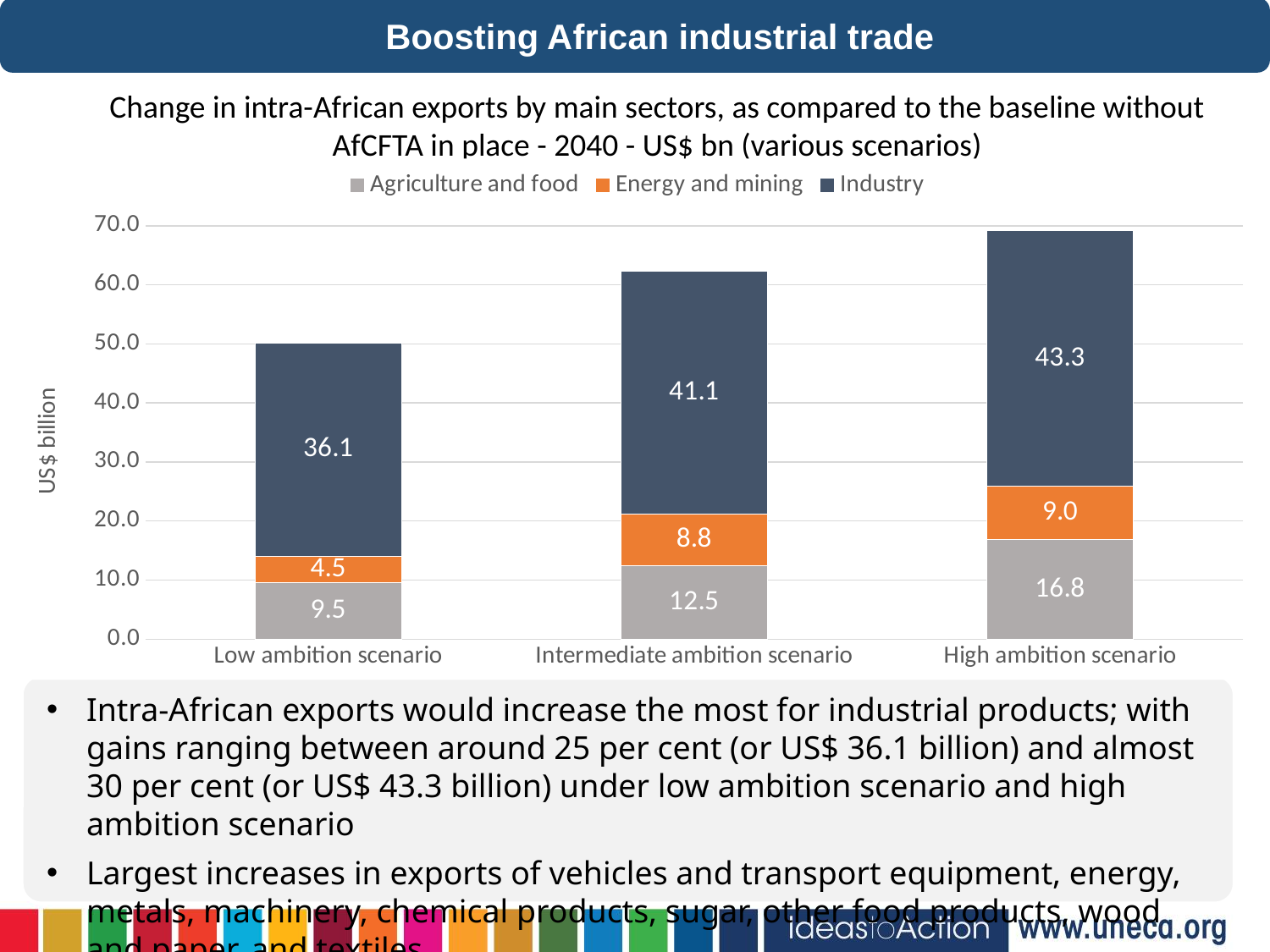
What is the total of the stacked bar for the High ambition scenario? 69.1 Which scenario has the lowest Agriculture and food value? Low ambition scenario What is the Energy and mining value for the Intermediate ambition scenario? 8.8 How many series does the legend list? 3 What is the Agriculture and food value for the High ambition scenario? 16.8 Which scenario has the highest Industry value? High ambition scenario What kind of chart is shown on the slide? Stacked bar chart What is the total of the stacked bar for the Intermediate ambition scenario? 62.4 What is the Industry value for the Low ambition scenario? 36.1 Which is larger: the Energy and mining value for the High ambition scenario or for the Intermediate ambition scenario? High ambition scenario How many scenarios are shown on the x axis? 3 What is the difference between the Industry values for the High ambition scenario and the Low ambition scenario? 7.2